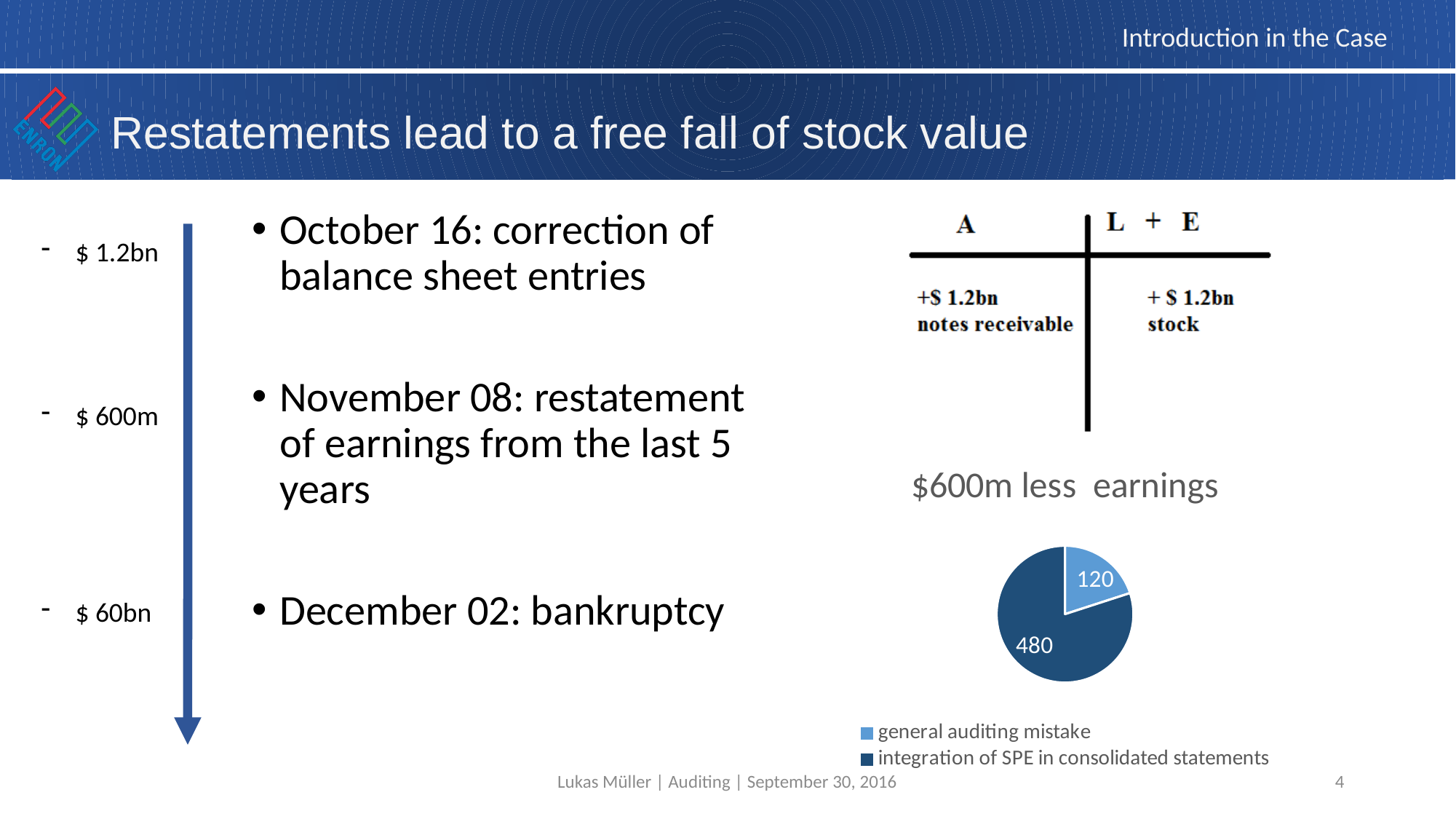
What is the value for 'integration of SPE in consolidated statements' in the pie chart? 480 Which slice of the pie chart is the smallest? general auditing mistake Which is larger in the pie chart: 'general auditing mistake' or 'integration of SPE in consolidated statements'? integration of SPE in consolidated statements What share of the pie does 'general auditing mistake' represent? 20% Which slice of the pie chart is the largest? integration of SPE in consolidated statements What is the value for 'general auditing mistake' in the pie chart? 120 How many slices does the pie chart have? 2 What kind of chart is shown on the slide? pie chart What is the total of the two slice values in the pie chart? 600 What colour is the 'general auditing mistake' slice in the pie chart? light blue How many entries does the pie chart legend list? 2 What is the difference between the two slice values in the pie chart? 360